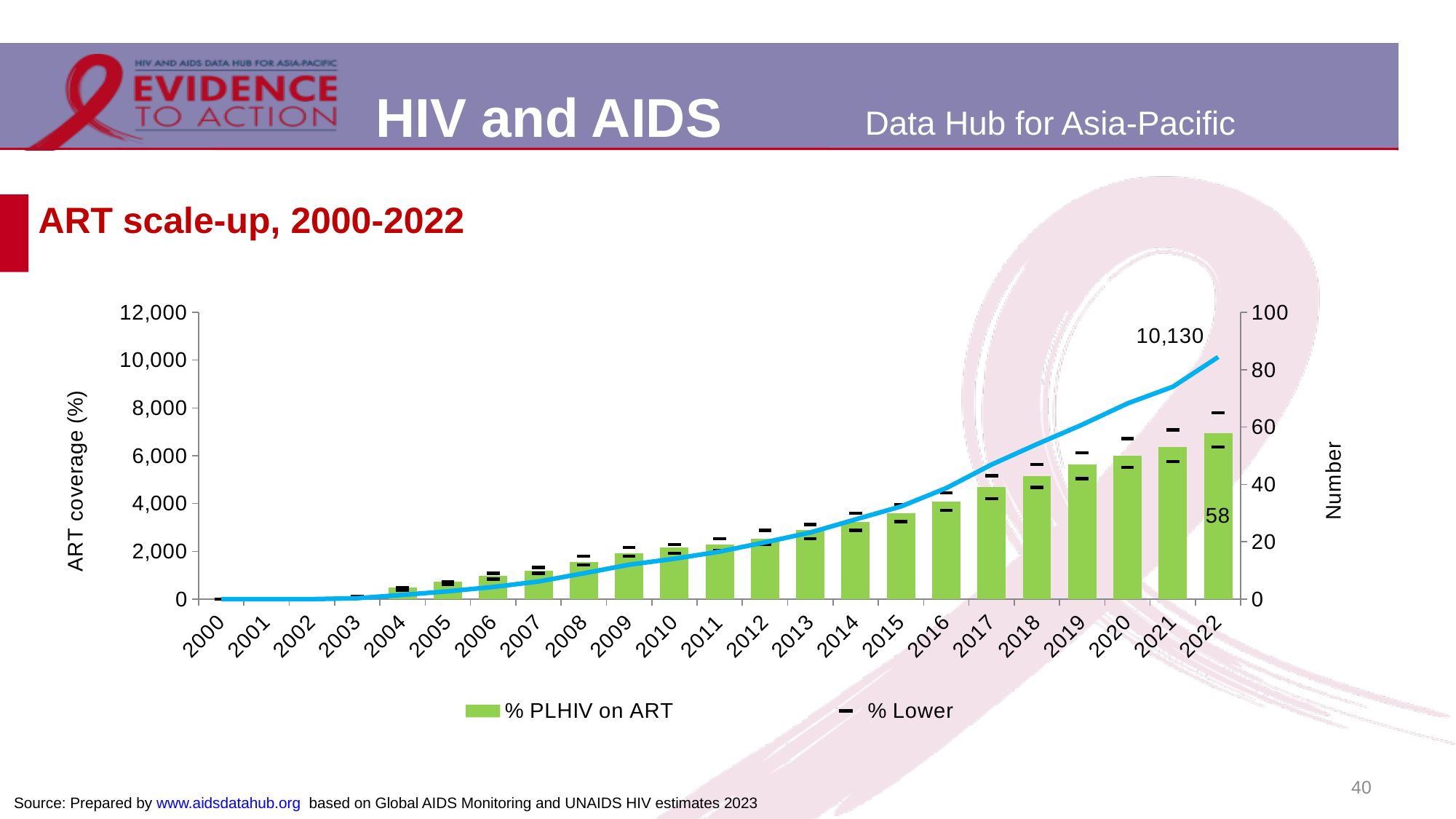
What is the % PLHIV on ART value labelled for 2022? 58 Is the % PLHIV on ART value for 2013 greater or less than 20? greater Do the % PLHIV on ART bars rise or fall from 2000 to 2022? rise What kind of chart is this? a bar chart combined with a line How many years are shown on the x axis? 23 Which year has the highest % PLHIV on ART bar? 2022 Is the % PLHIV on ART value for 2015 greater or less than 40? less What is the title of the chart? ART scale-up, 2000-2022 What value is labelled on the blue line for 2022? 10,130 How many series does the legend list? 2 Which year has the larger % PLHIV on ART bar, 2010 or 2022? 2022 What colour are the % PLHIV on ART bars? green